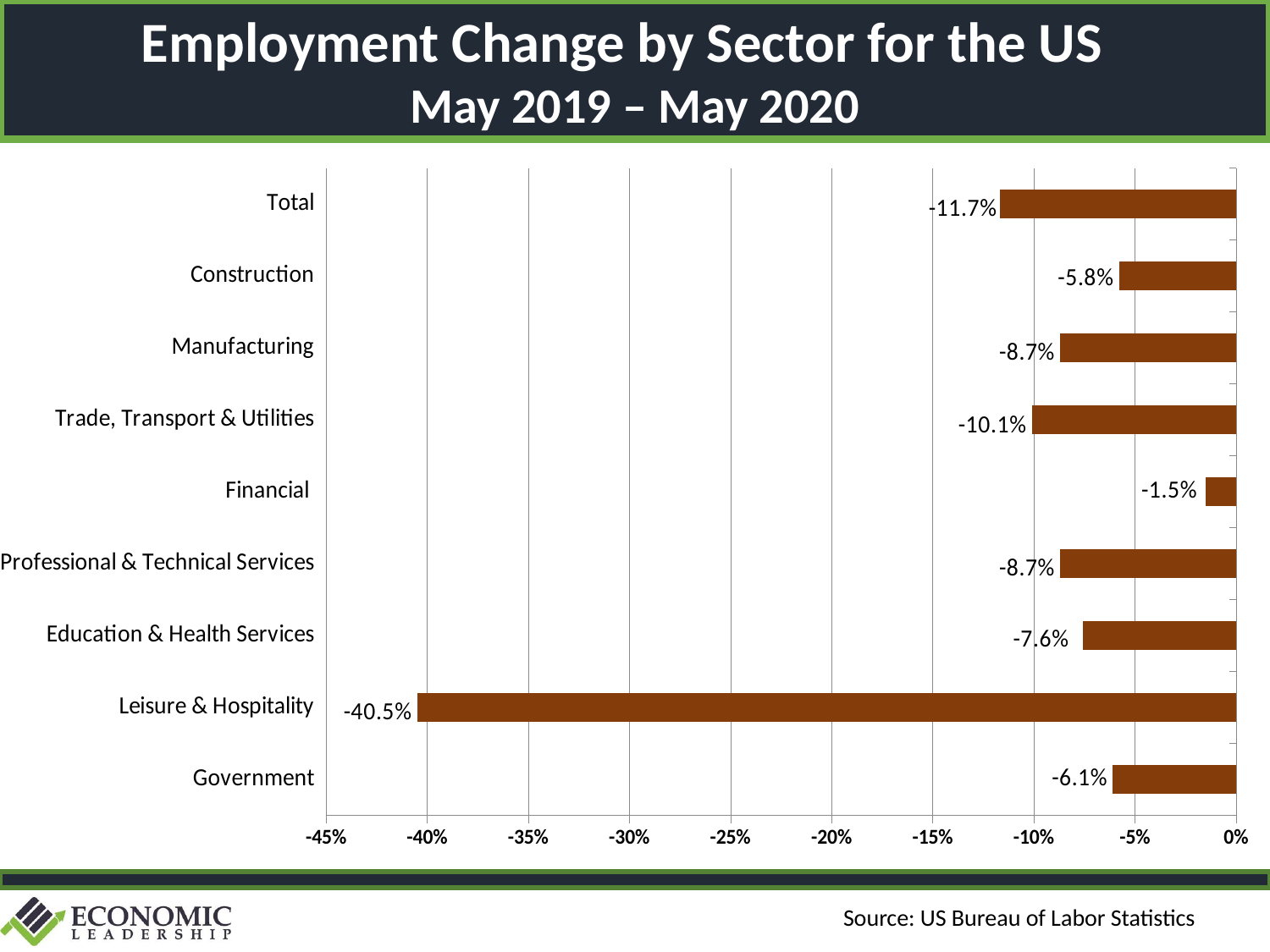
What is the difference between the employment change for Construction and Government? 0.3 percentage points Which sector shows the largest employment decline? Leisure & Hospitality What is the employment change for Financial? -1.5% What kind of chart is shown on the slide? Bar chart Is the value for Manufacturing greater or less than -10%? greater How many categories are plotted on the chart? 9 Which sector shows the smallest employment decline? Financial What is the employment change shown for Total? -11.7% What is the employment change for Government? -6.1% Which sector had a larger employment decline, Trade, Transport & Utilities or Education & Health Services? Trade, Transport & Utilities What is the source cited for the chart data? US Bureau of Labor Statistics What is the employment change for Leisure & Hospitality? -40.5%